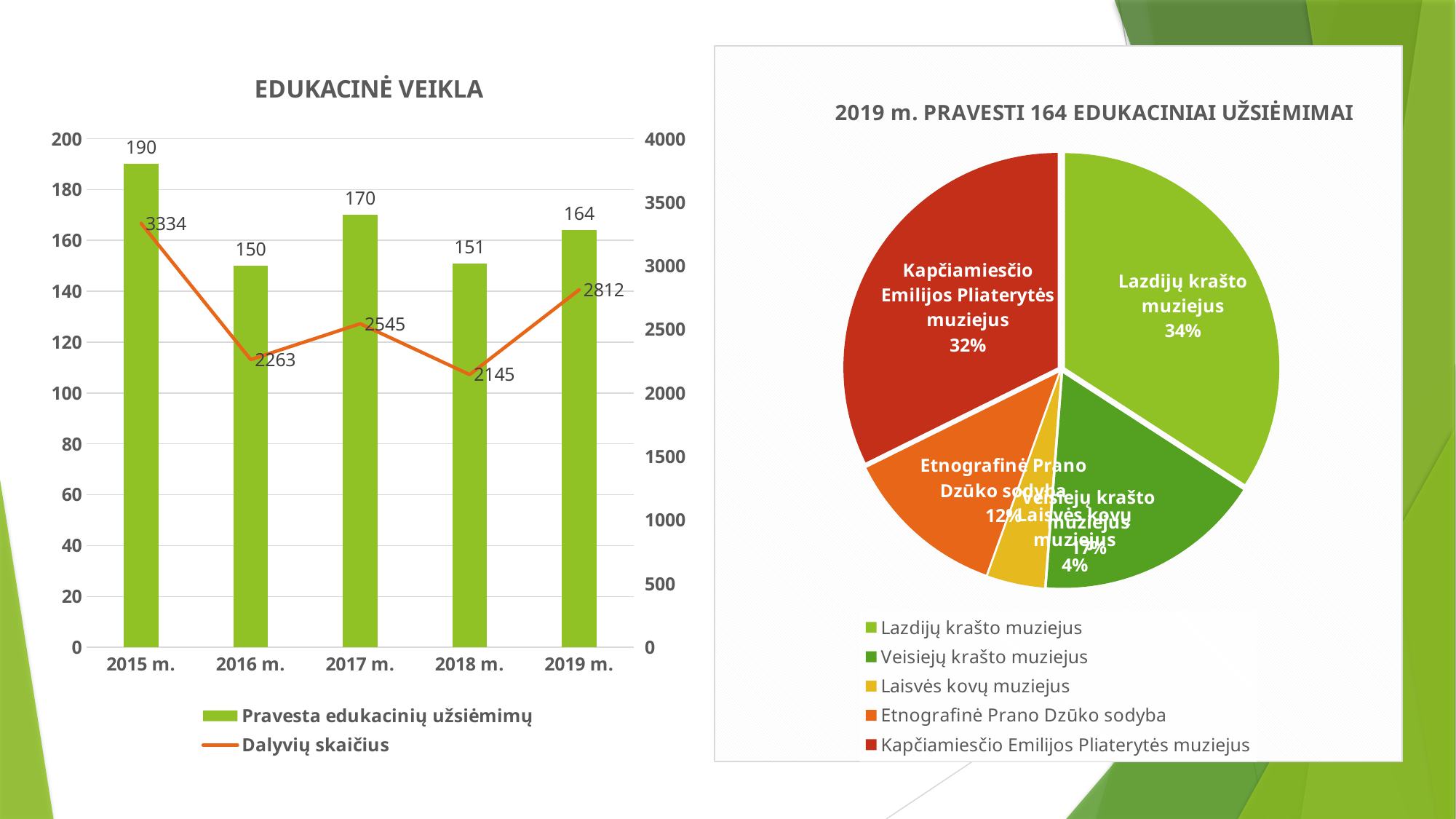
How many years are shown on the x axis of the "EDUKACINĖ VEIKLA" chart? 5 In the "EDUKACINĖ VEIKLA" chart, what was the number of participants (Dalyvių skaičius) in 2015 m.? 3334 How many series does the legend of the "EDUKACINĖ VEIKLA" chart list? 2 In the pie chart "2019 m. PRAVESTI 164 EDUKACINIAI UŽSIĖMIMAI", what share belongs to Kapčiamiesčio Emilijos Pliaterytės muziejus? 32% What type of chart is the chart on the right side of the slide? Pie chart In the pie chart "2019 m. PRAVESTI 164 EDUKACINIAI UŽSIĖMIMAI", what share belongs to Lazdijų krašto muziejus? 34% In the "EDUKACINĖ VEIKLA" chart, which year had the highest number of educational sessions? 2015 m. In the "EDUKACINĖ VEIKLA" chart, how many educational sessions (Pravesta edukacinių užsiėmimų) were held in 2017 m.? 170 In the pie chart "2019 m. PRAVESTI 164 EDUKACINIAI UŽSIĖMIMAI", which museum has the smallest share? Laisvės kovų muziejus In the "EDUKACINĖ VEIKLA" chart, were more educational sessions held in 2016 m. or 2018 m.? 2018 m. In the "EDUKACINĖ VEIKLA" chart, which year had the lowest number of participants (Dalyvių skaičius)? 2018 m. In the "EDUKACINĖ VEIKLA" chart, what is the difference in participants between 2019 m. and 2018 m.? 667